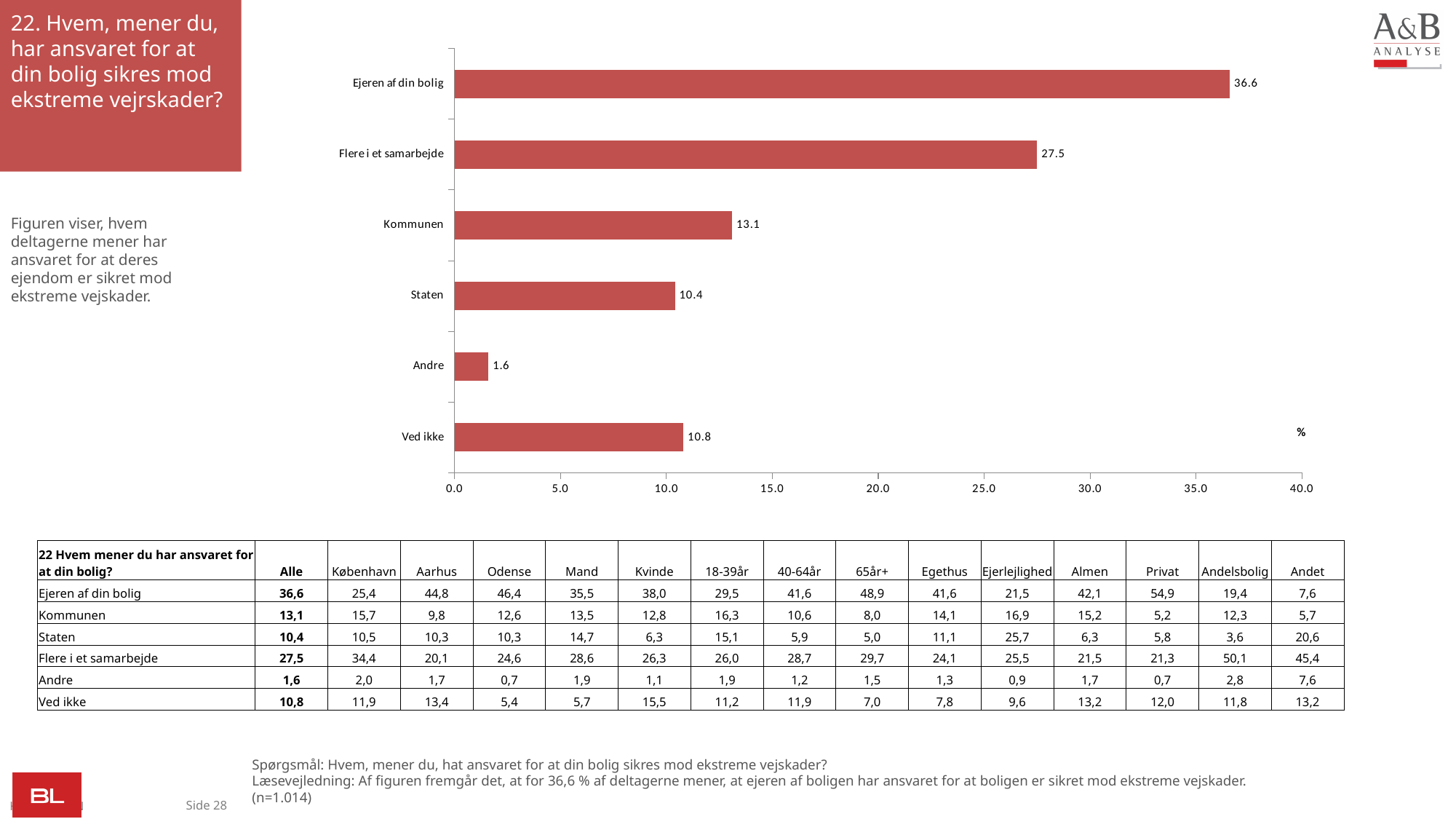
What value is shown for "Flere i et samarbejde" in the chart? 27.5 How many categories are shown in the chart? 6 What is the difference between the values for "Ejeren af din bolig" and "Flere i et samarbejde"? 9.1 What kind of chart is shown on the slide? bar chart Is the value for "Kommunen" greater or less than 15.0? less What value is shown for "Kommunen" in the chart? 13.1 Which category has the highest value in the chart? Ejeren af din bolig Which is larger, the value for "Staten" or the value for "Ved ikke"? Ved ikke Which category has the lowest value in the chart? Andre What value is shown for "Ejeren af din bolig" in the chart? 36.6 What is the maximum value shown on the chart's horizontal axis? 40.0 What value is shown for "Ved ikke" in the chart? 10.8